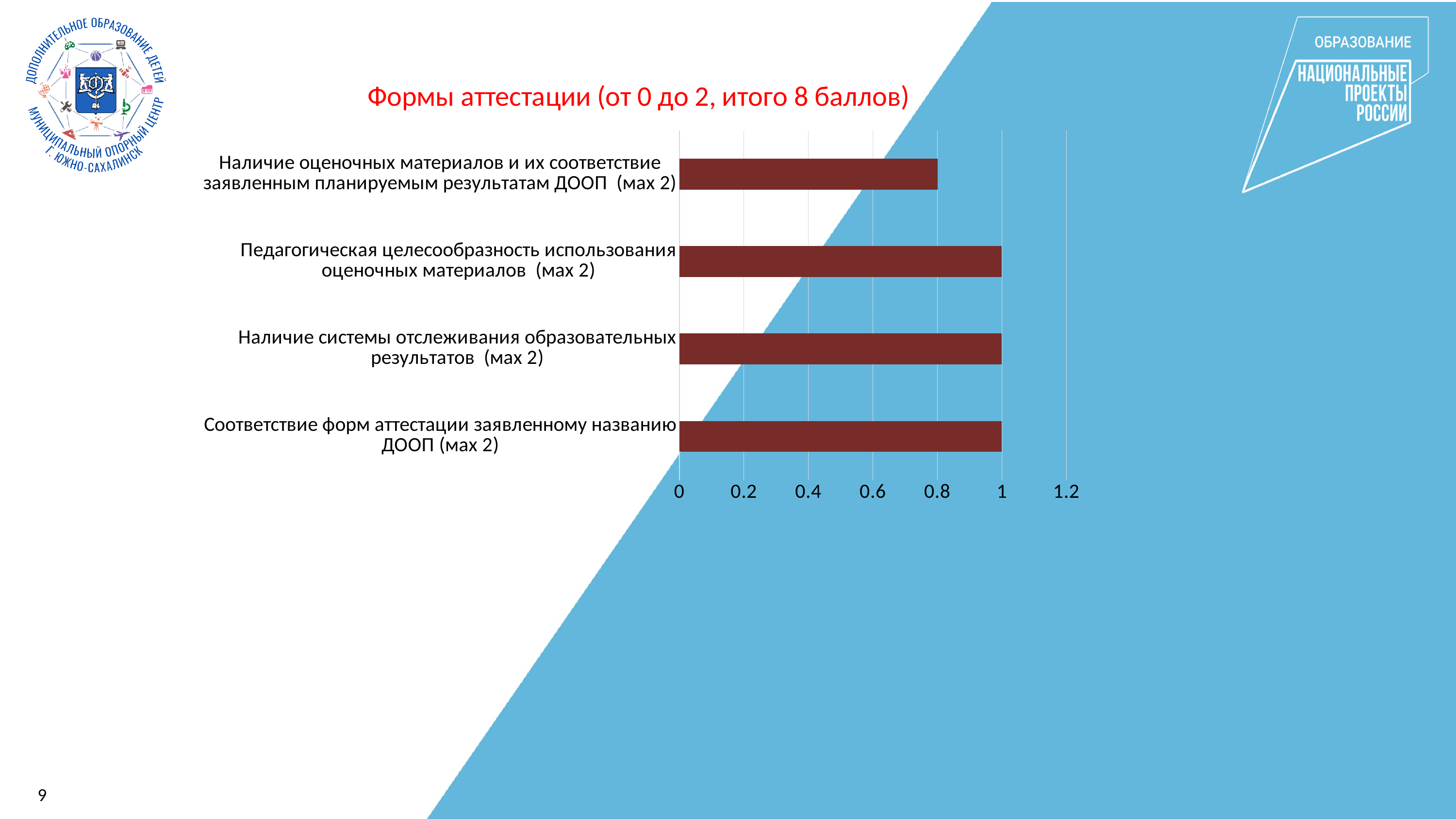
What is the value for "Наличие оценочных материалов и их соответствие заявленным планируемым результатам ДООП (мах 2)"? 0.8 What is the highest tick value shown on the horizontal axis of the chart? 1.2 Is the value for "Наличие оценочных материалов и их соответствие заявленным планируемым результатам ДООП (мах 2)" greater or less than 1? less What kind of chart is shown on the slide? bar chart How many categories in the chart have a value of 1? 3 Which is larger: the value for "Наличие системы отслеживания образовательных результатов (мах 2)" or for "Наличие оценочных материалов и их соответствие заявленным планируемым результатам ДООП (мах 2)"? Наличие системы отслеживания образовательных результатов (мах 2) What is the value for "Соответствие форм аттестации заявленному названию ДООП (мах 2)"? 1 What is the difference between the value for "Соответствие форм аттестации заявленному названию ДООП (мах 2)" and the value for "Наличие оценочных материалов и их соответствие заявленным планируемым результатам ДООП (мах 2)"? 0.2 Which category has the lowest value in the chart? Наличие оценочных материалов и их соответствие заявленным планируемым результатам ДООП (мах 2) What is the value for "Наличие системы отслеживания образовательных результатов (мах 2)"? 1 How many categories are plotted in the chart? 4 What is the value for "Педагогическая целесообразность использования оценочных материалов (мах 2)"? 1